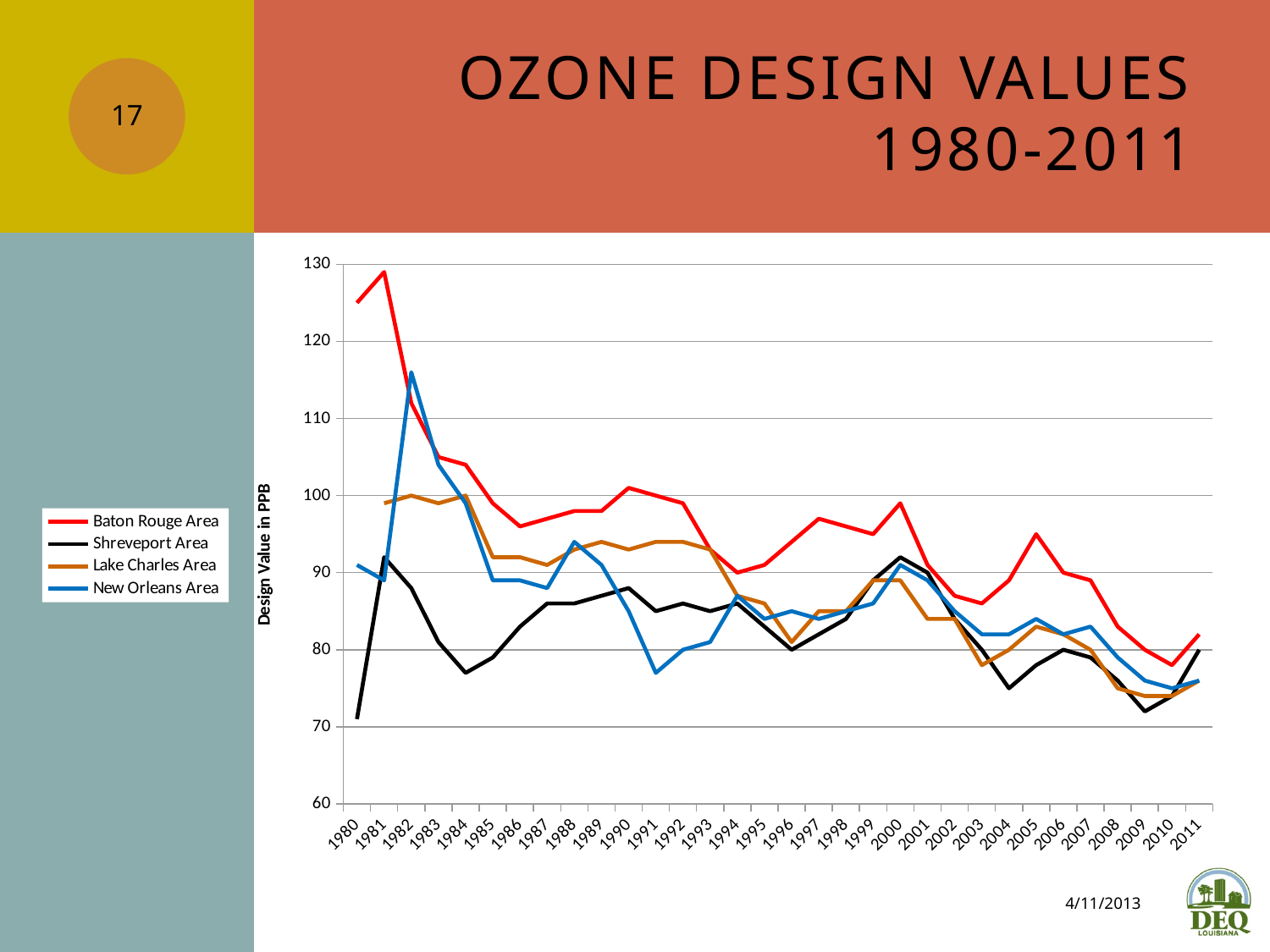
Which area has the lowest value in 1980? Shreveport Area Is the value for Lake Charles Area in 1996 greater or less than 90? less How many years are plotted along the x axis? 32 Is the value for Baton Rouge Area in 1981 greater or less than 120? greater What kind of chart is shown on the slide? line chart How many series does the legend list? 4 Overall, does the Baton Rouge Area line rise or fall from 1980 to 2011? fall Is the value for New Orleans Area in 1982 greater or less than 110? greater In 1990, which is larger: the value for Baton Rouge Area or the value for Shreveport Area? Baton Rouge Area Which area has the highest value in 1981? Baton Rouge Area What is the label on the vertical axis? Design Value in PPB